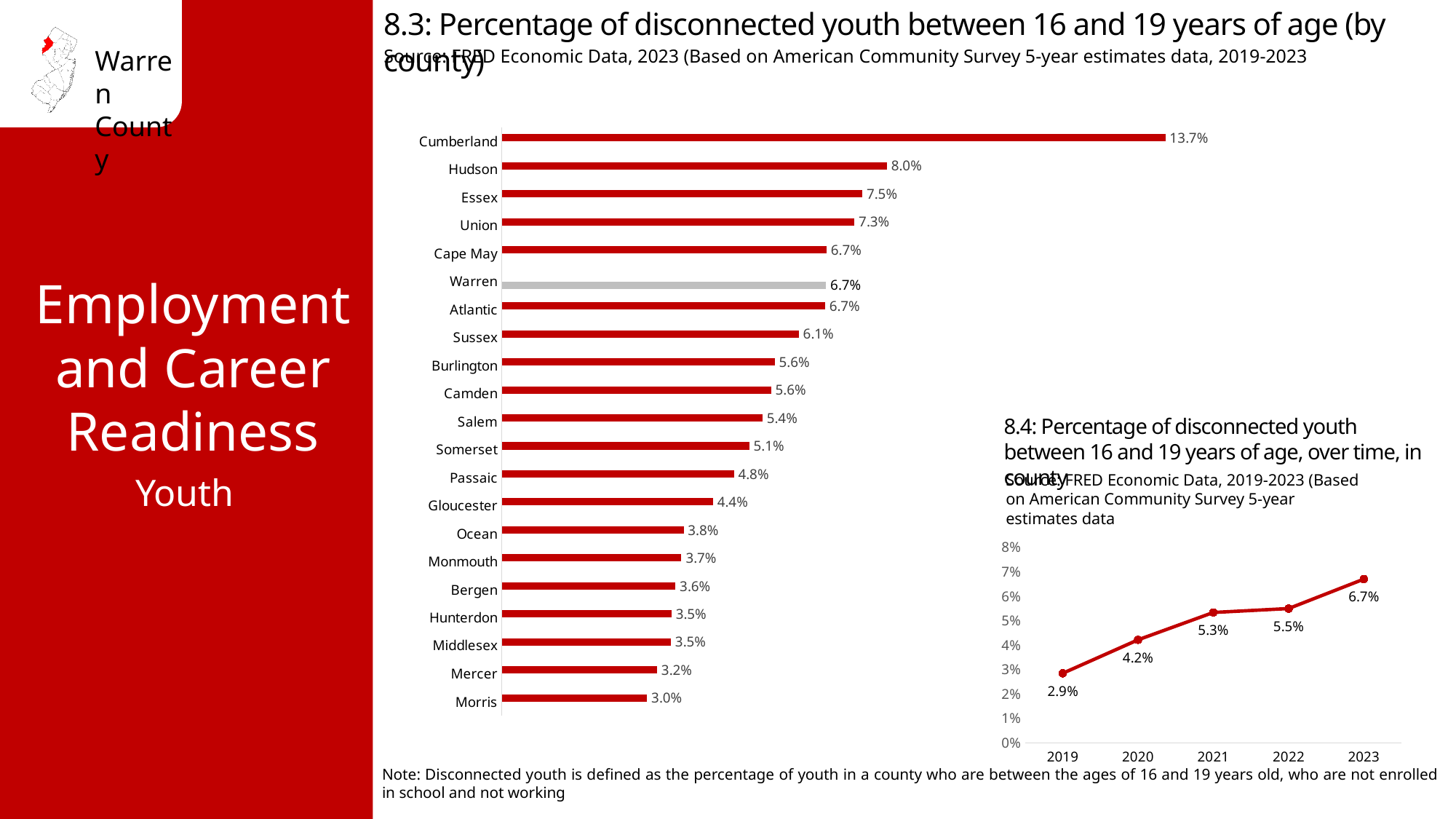
In chart 8.4 (over time), how many years are plotted? 5 In chart 8.3 (by county), which county has a higher percentage, Essex or Sussex? Essex In chart 8.3 (by county), which county has the lowest percentage of disconnected youth? Morris In chart 8.4 (over time), what is the percentage of disconnected youth in 2019? 2.9% In chart 8.4 (over time), what is the difference between the 2023 and 2019 values? 3.8% In chart 8.3 (by county), how many counties are shown? 21 In chart 8.4 (over time), do the values rise or fall from 2019 to 2023? Rise In chart 8.3 (by county), what is the percentage of disconnected youth for Warren? 6.7% What kind of chart is chart 8.3 (by county)? Bar chart In chart 8.3 (by county), which county has the highest percentage of disconnected youth? Cumberland In chart 8.3 (by county), what is the difference between Cumberland's and Hudson's percentages? 5.7% In chart 8.3 (by county), what is the percentage of disconnected youth for Cumberland? 13.7%